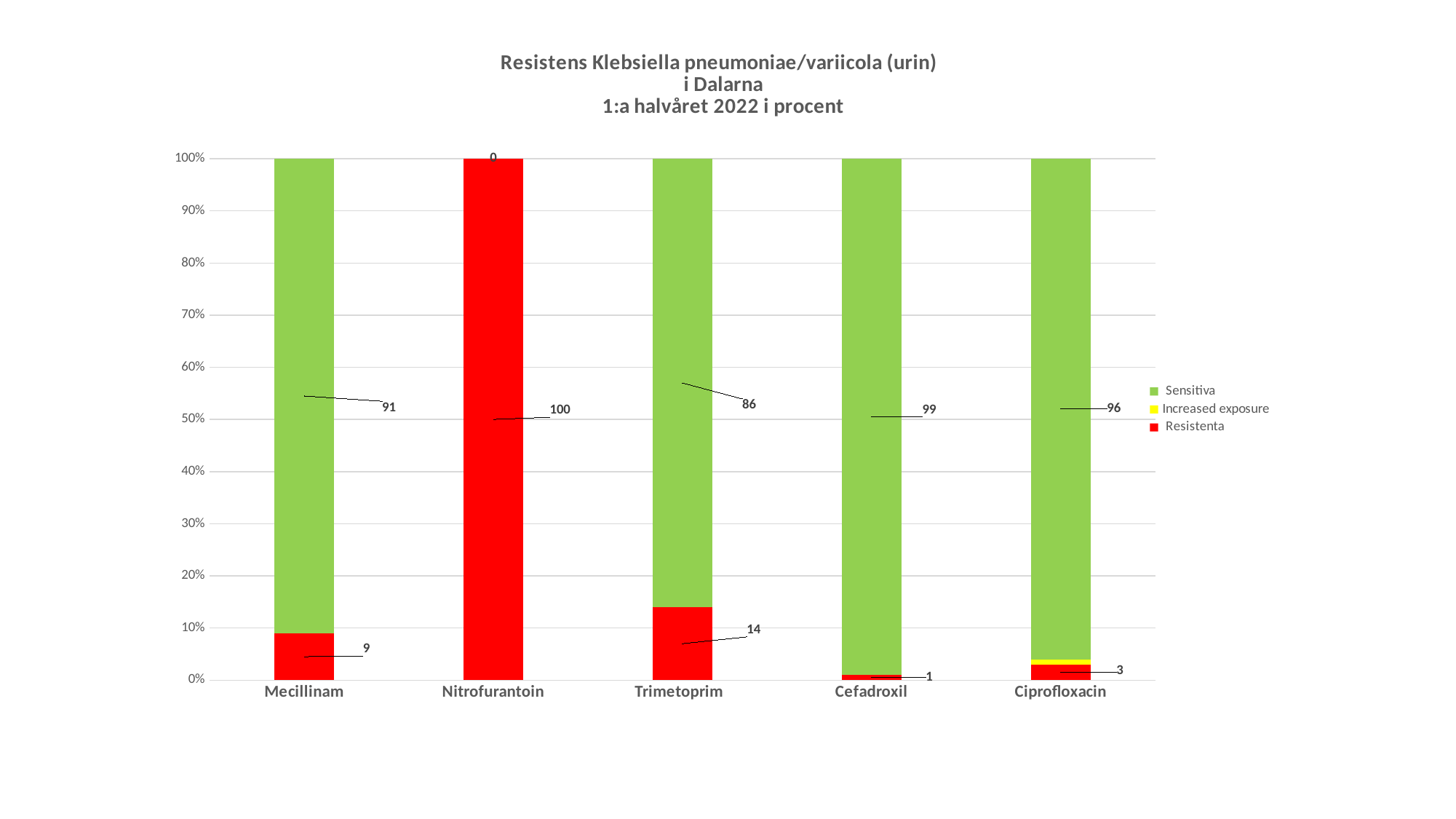
What is the Resistenta value for Nitrofurantoin? 100 Which antibiotic has the highest Resistenta value? Nitrofurantoin How many series does the legend list? 3 How many antibiotics are shown on the x axis? 5 Which antibiotic has the lowest Sensitiva value? Nitrofurantoin What kind of chart is shown on the slide? Stacked bar chart Which has a larger Resistenta value, Mecillinam or Ciprofloxacin? Mecillinam What is the Sensitiva value for Cefadroxil? 99 What is the difference between the Sensitiva values for Cefadroxil and Trimetoprim? 13 What is the Resistenta value for Trimetoprim? 14 Which colour represents the Resistenta series in the legend? Red What is the Sensitiva value for Mecillinam? 91